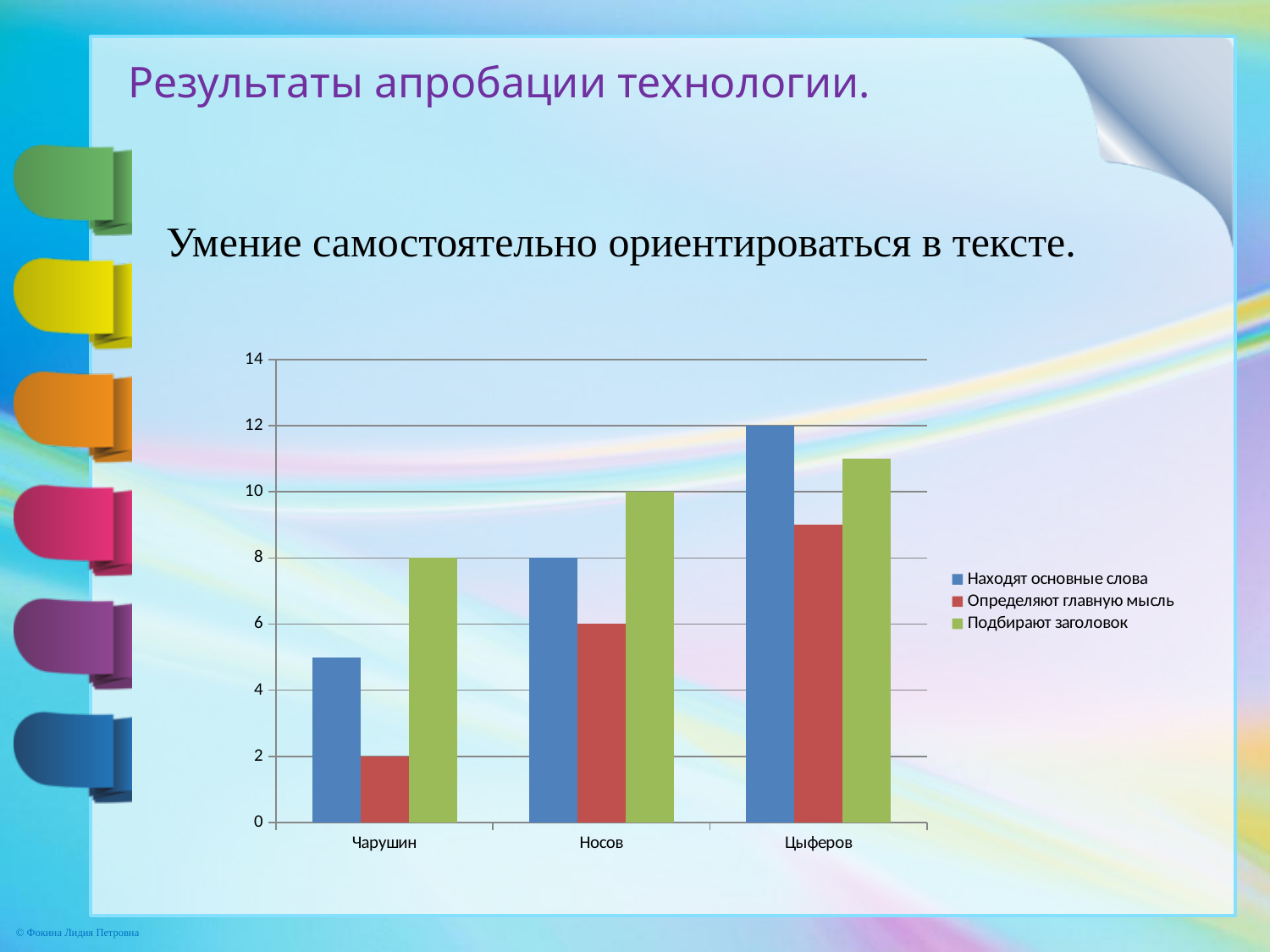
How many categories are shown on the x axis? 3 What is the value for Подбирают заголовок for Чарушин? 8 Is the value for Определяют главную мысль for Цыферов greater or less than 10? less What is the value for Определяют главную мысль for Чарушин? 2 What is the value for Находят основные слова for Цыферов? 12 What is the difference between Подбирают заголовок for Носов and Подбирают заголовок for Чарушин? 2 Which category has the highest value for Находят основные слова? Цыферов What is the value for Подбирают заголовок for Носов? 10 How many series does the legend list? 3 Is the value for Находят основные слова for Чарушин greater or less than 4? greater What is the value for Находят основные слова for Носов? 8 What kind of chart is shown on the slide? bar chart